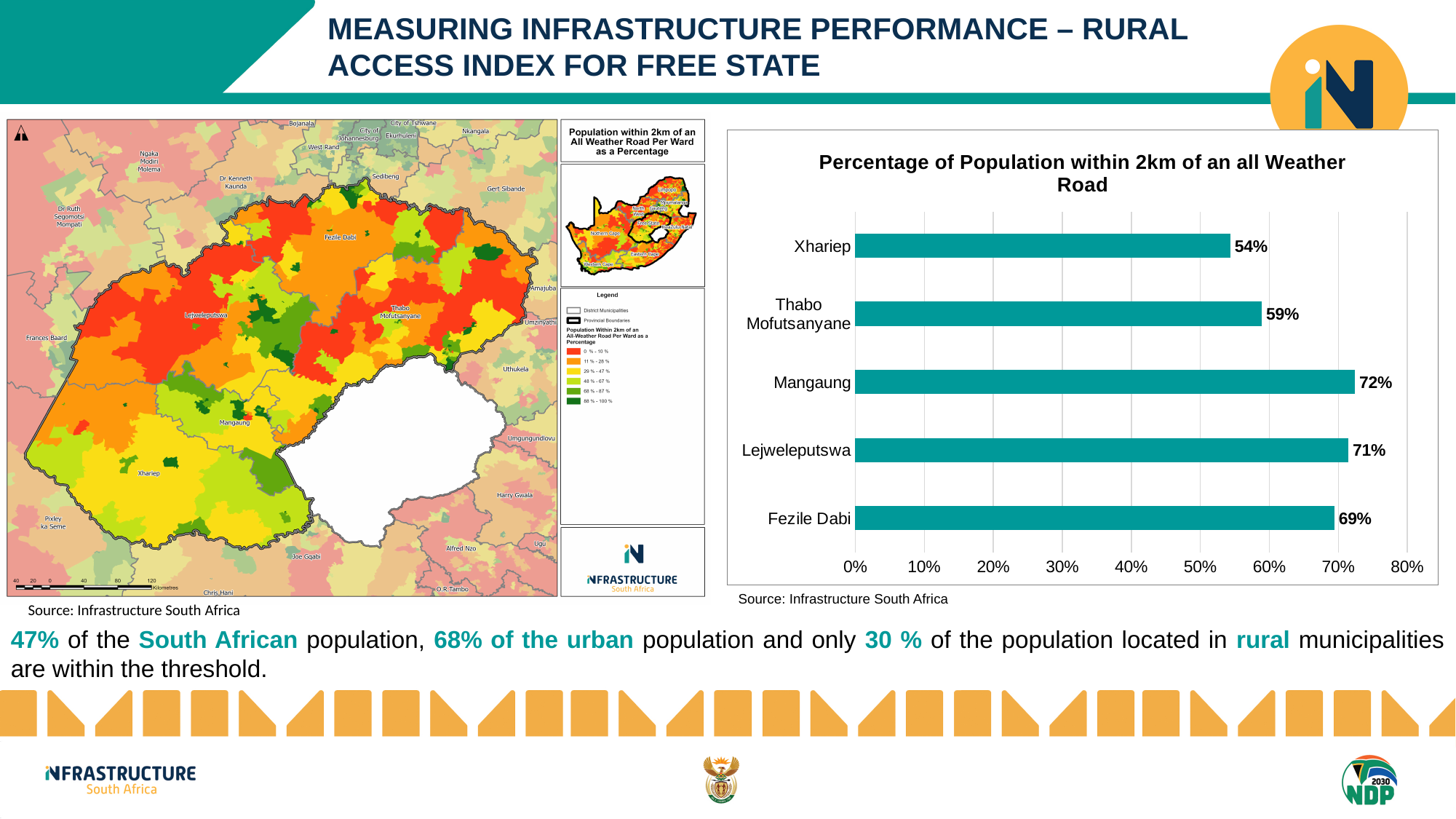
What is the value for Xhariep in the bar chart? 54% Which district has the highest percentage of population within 2km of an all weather road? Mangaung What is the title of the bar chart? Percentage of Population within 2km of an all Weather Road What is the value for Fezile Dabi in the bar chart? 69% What is the value for Thabo Mofutsanyane in the bar chart? 59% Which is larger, the value for Thabo Mofutsanyane or the value for Fezile Dabi? Fezile Dabi What kind of chart is used to show the percentage of population within 2km of an all weather road? Bar chart Which district has the lowest percentage of population within 2km of an all weather road? Xhariep How many districts are shown in the bar chart? 5 Is the value for Lejweleputswa greater or less than 60%? greater What is the difference between the values for Mangaung and Xhariep? 18% What is the difference between the values for Lejweleputswa and Fezile Dabi? 2%